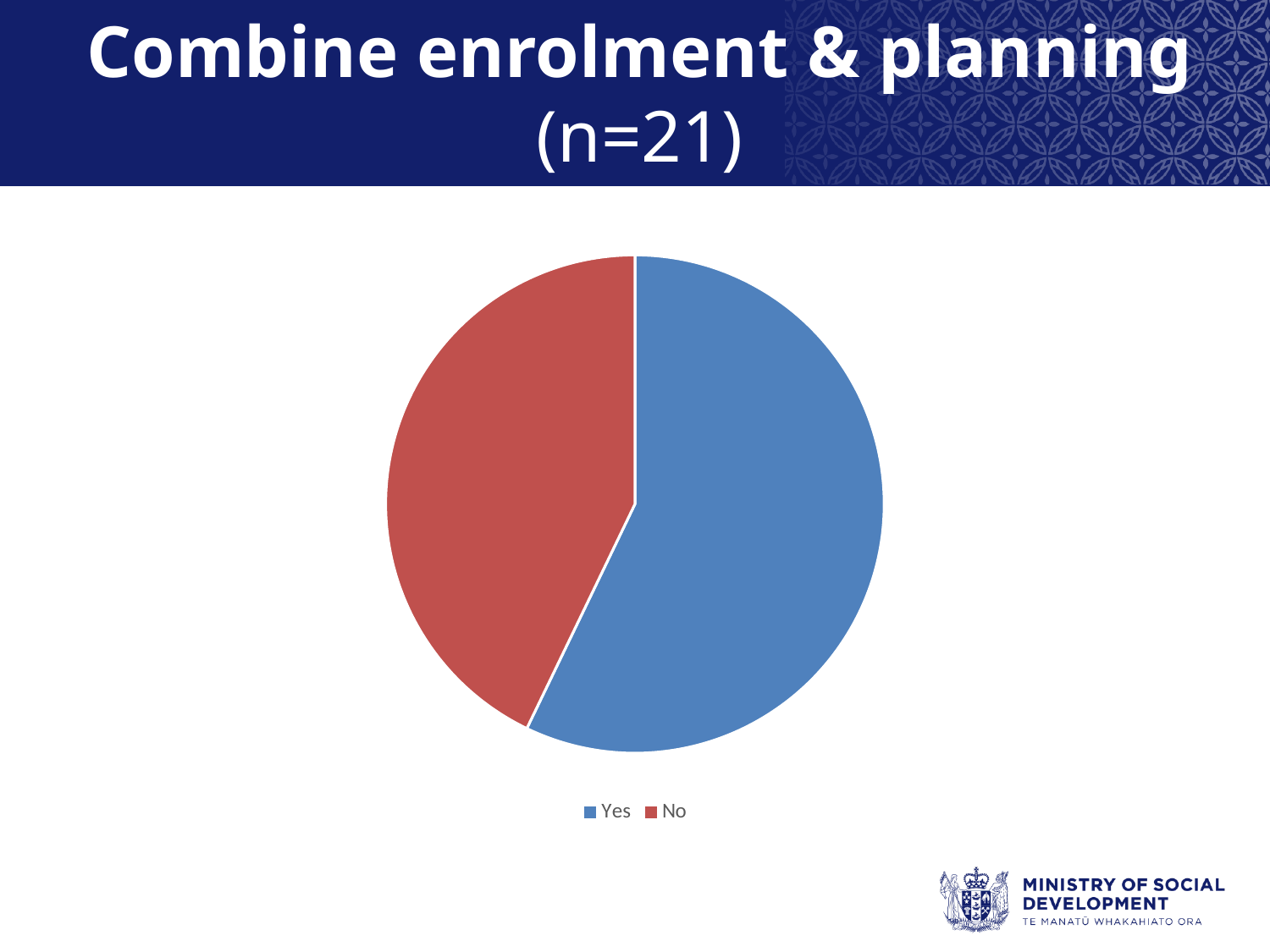
Which slice is larger, Yes or No? Yes How many slices does the pie chart have? 2 How many entries does the legend list? 2 Which category has the smallest slice of the pie? No What is the title of the chart on the slide? Combine enrolment & planning (n=21) What sample size (n) is given in the slide title? 21 Does the Yes slice take up more or less than half of the pie? More Which category has the largest slice of the pie? Yes What kind of chart is shown on the slide? Pie chart What colour is the Yes slice in the pie chart? Blue